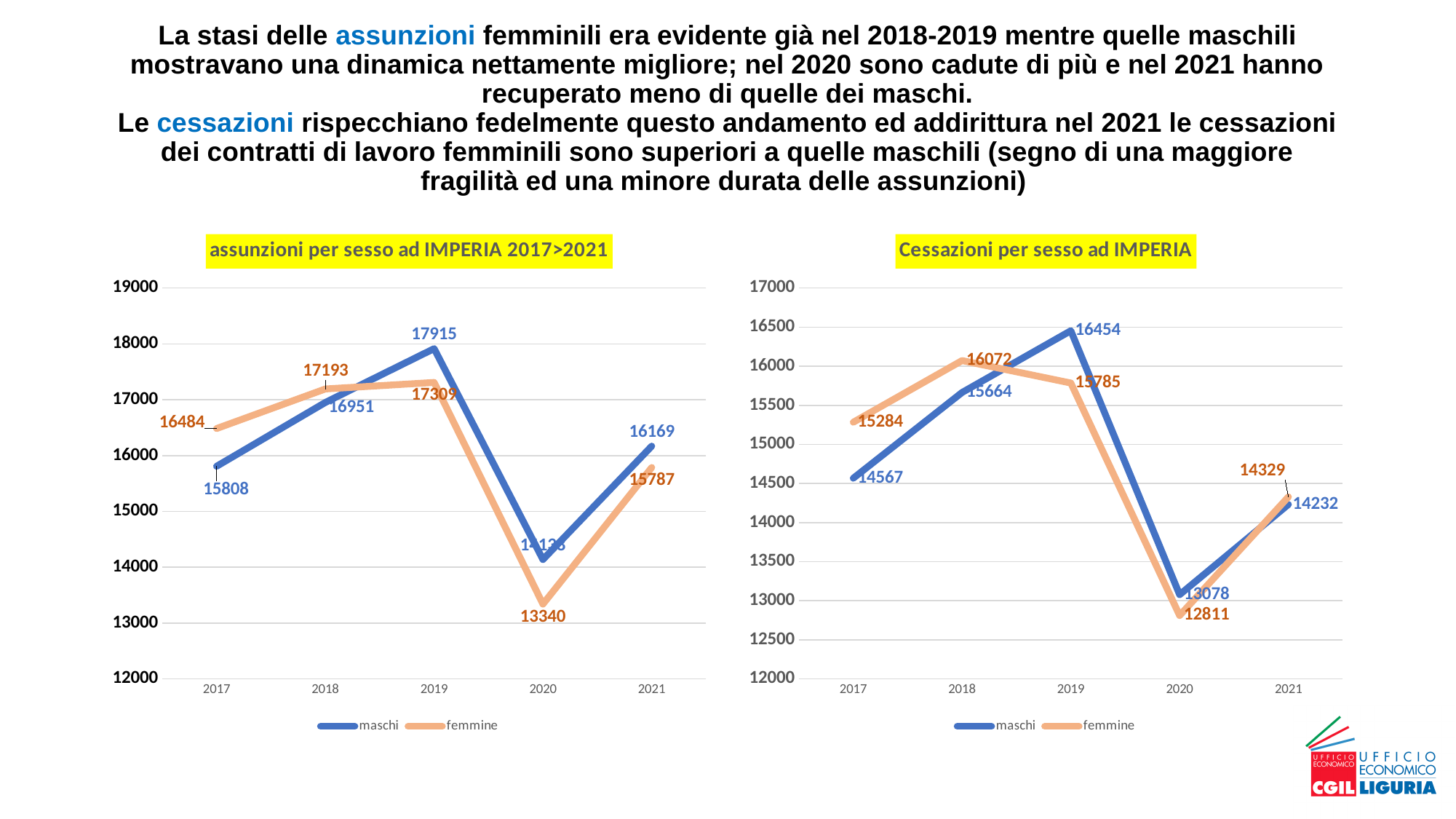
In the chart 'assunzioni per sesso ad IMPERIA 2017>2021', in which year is the femmine series highest? 2019 In the chart 'assunzioni per sesso ad IMPERIA 2017>2021', what is the difference between maschi and femmine in 2021? 382 In the chart 'Cessazioni per sesso ad IMPERIA', what is the value for maschi in 2019? 16454 In the chart 'Cessazioni per sesso ad IMPERIA', what is the value for femmine in 2021? 14329 In the chart 'Cessazioni per sesso ad IMPERIA', in which year is the femmine series lowest? 2020 How many series does the legend of the chart 'Cessazioni per sesso ad IMPERIA' list? 2 In the chart 'assunzioni per sesso ad IMPERIA 2017>2021', which series has the larger value in 2017, maschi or femmine? femmine In the chart 'assunzioni per sesso ad IMPERIA 2017>2021', what is the value for maschi in 2019? 17915 In the chart 'Cessazioni per sesso ad IMPERIA', what is the difference between femmine and maschi in 2018? 408 In the chart 'Cessazioni per sesso ad IMPERIA', how many years are shown on the x axis? 5 In the chart 'assunzioni per sesso ad IMPERIA 2017>2021', what is the value for femmine in 2020? 13340 What kind of chart is 'assunzioni per sesso ad IMPERIA 2017>2021'? line chart